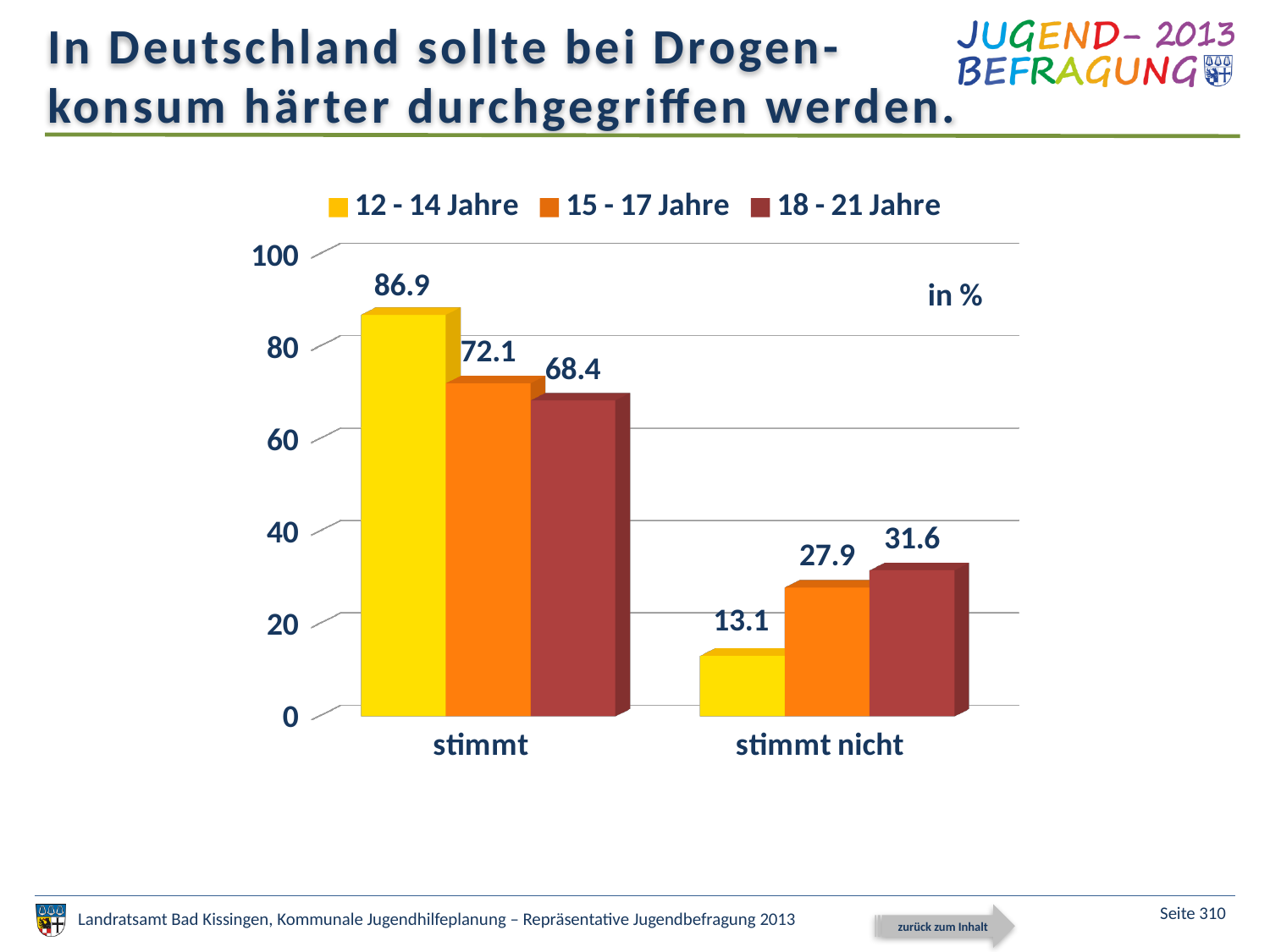
What is the value for the 15 - 17 Jahre series in the "stimmt nicht" category? 27.9 Which is larger: the 15 - 17 Jahre value for "stimmt" or the 18 - 21 Jahre value for "stimmt"? 15 - 17 Jahre How many series does the legend list? 3 What kind of chart is shown on the slide? bar chart How many categories are shown on the x axis? 2 What is the value for the 18 - 21 Jahre series in the "stimmt nicht" category? 31.6 Which age group has the highest value in the "stimmt" category? 12 - 14 Jahre What unit is indicated for the values in the chart? in % Which age group has the lowest value in the "stimmt nicht" category? 12 - 14 Jahre Is the value for 18 - 21 Jahre in the "stimmt nicht" category greater or less than 40? less What is the value for the 12 - 14 Jahre series in the "stimmt" category? 86.9 What is the difference between the 12 - 14 Jahre and 18 - 21 Jahre values in the "stimmt" category? 18.5